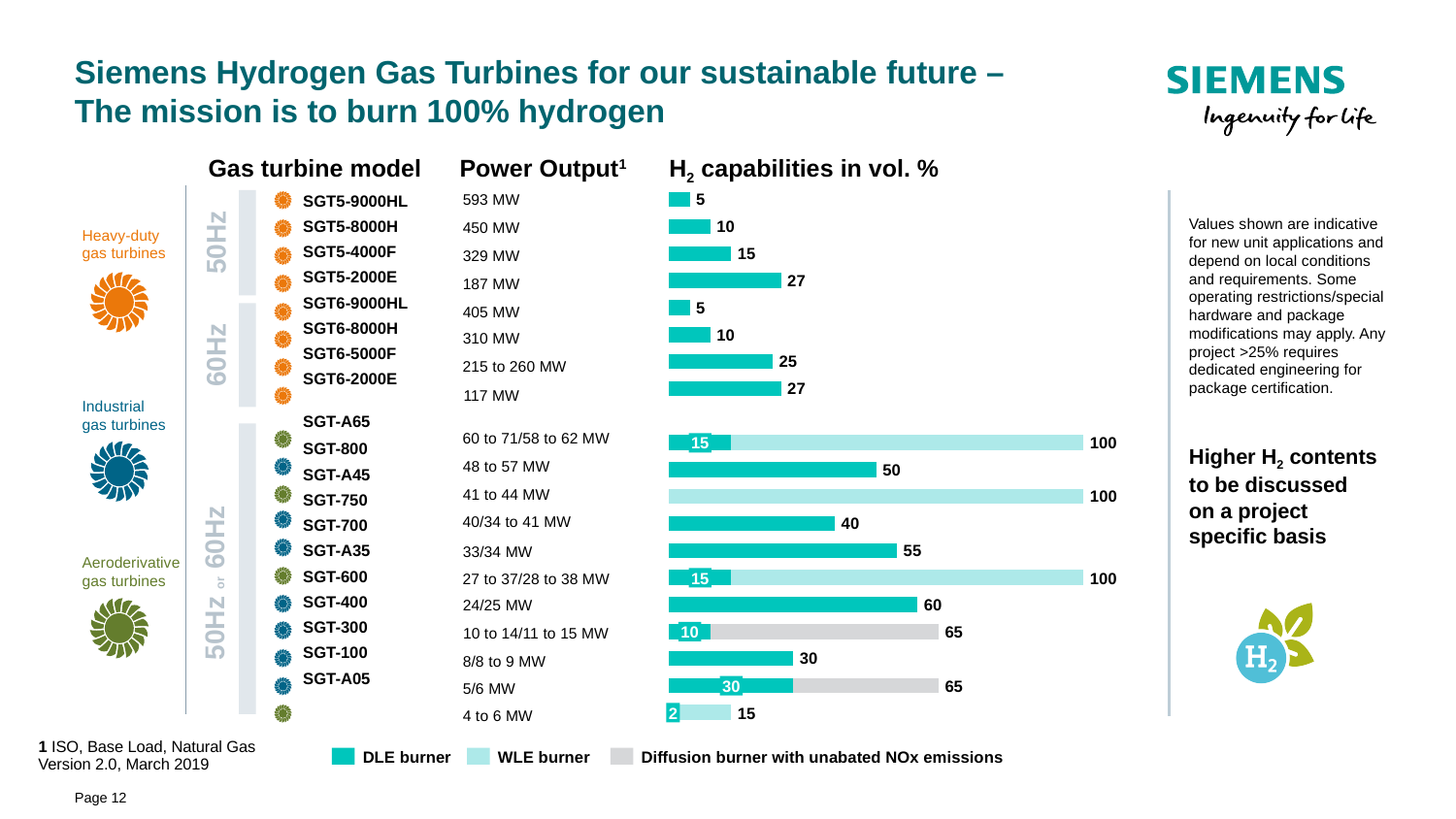
What is the H2 capability in vol. % shown for the SGT5-2000E? 27 What is the H2 capability in vol. % shown for the SGT6-5000F? 25 What are the three burner types listed in the chart legend? DLE burner, WLE burner, Diffusion burner with unabated NOx emissions Which has a higher H2 capability, the SGT-700 or the SGT-750? SGT-700 What is the H2 capability in vol. % shown for the SGT-700? 55 Among the 50Hz heavy-duty gas turbines (SGT5 models), which has the highest H2 capability? SGT5-2000E What is the H2 capability in vol. % shown for the SGT-800? 50 How many burner types does the chart legend list? 3 What is the difference in H2 capability (vol. %) between the SGT-600 and the SGT-800? 10 What H2 capability in vol. % is shown for the SGT-100 with the diffusion burner? 65 What kind of chart is used to show the H2 capabilities? Bar chart